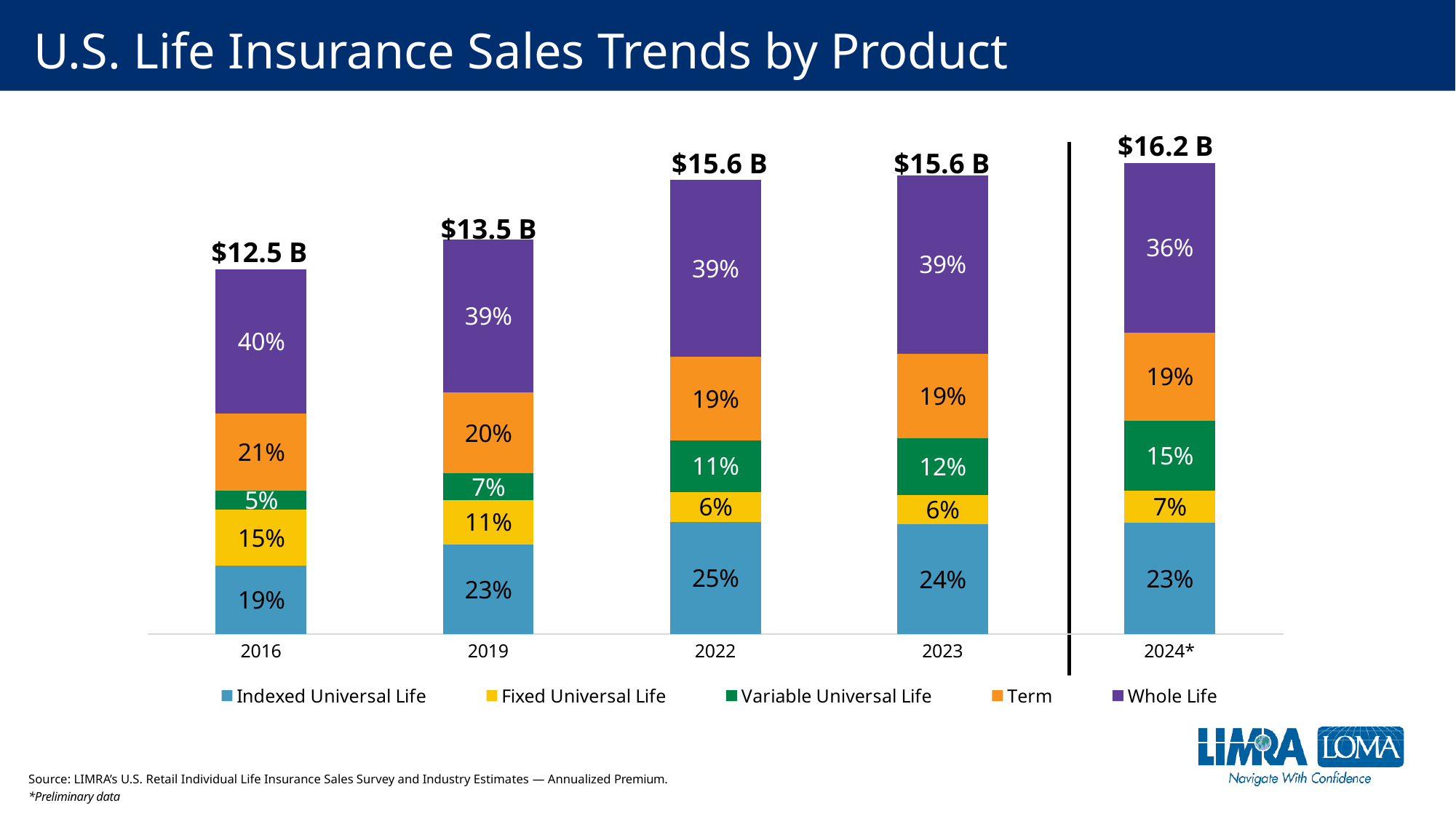
What share did Variable Universal Life have in 2019? 7% What was the total annualized premium shown above the 2024* bar? $16.2 B What share of sales did Whole Life account for in 2016? 40% Which year has the highest total annualized premium? 2024* What percentage of sales was Indexed Universal Life in 2022? 25% How many years are shown on the x axis? 5 Which is larger: the Fixed Universal Life share in 2016 or in 2023? 2016 Which year has the lowest total annualized premium? 2016 What is the difference between the total premium in 2024* and in 2016? $3.7 B Which product is shown in purple in the legend? Whole Life What kind of chart is shown on the slide? Stacked bar chart How many product series does the legend list? 5